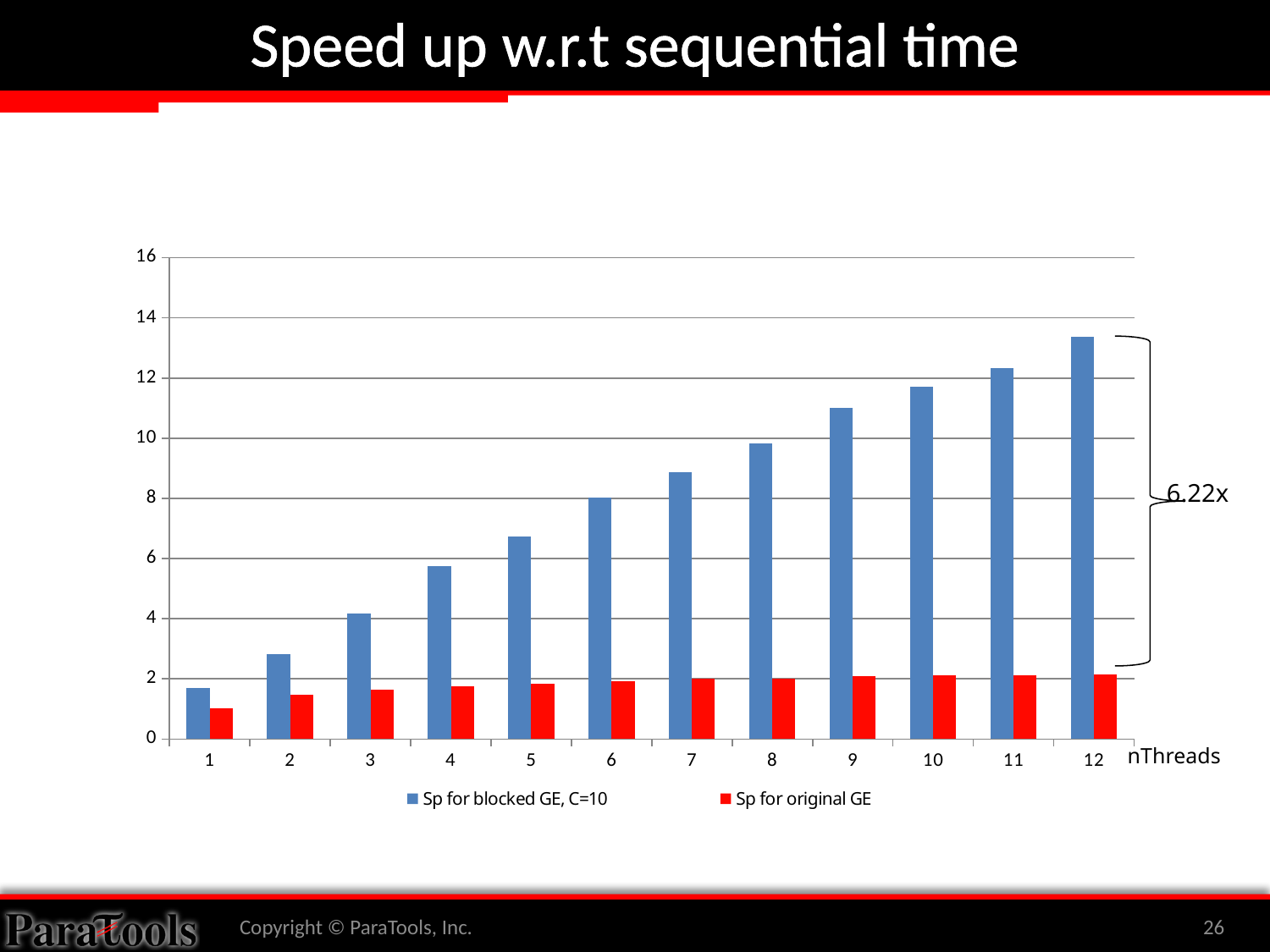
Is the value for blocked GE, C=10 at 4 threads greater or less than 4? greater Is the value for original GE at 12 threads greater or less than 4? less At which nThreads value is the speedup for original GE lowest? 1 How many nThreads categories are shown on the x axis? 12 At 12 threads, which series has the larger speedup: blocked GE, C=10 or original GE? Sp for blocked GE, C=10 Is the value for original GE at 1 thread greater or less than 2? less What kind of chart is shown on the slide? bar chart Does the speedup for blocked GE, C=10 rise or fall as nThreads increases from 1 to 12? rise How many series does the legend list? 2 At which nThreads value is the speedup for blocked GE, C=10 highest? 12 At which nThreads value is the speedup for blocked GE, C=10 lowest? 1